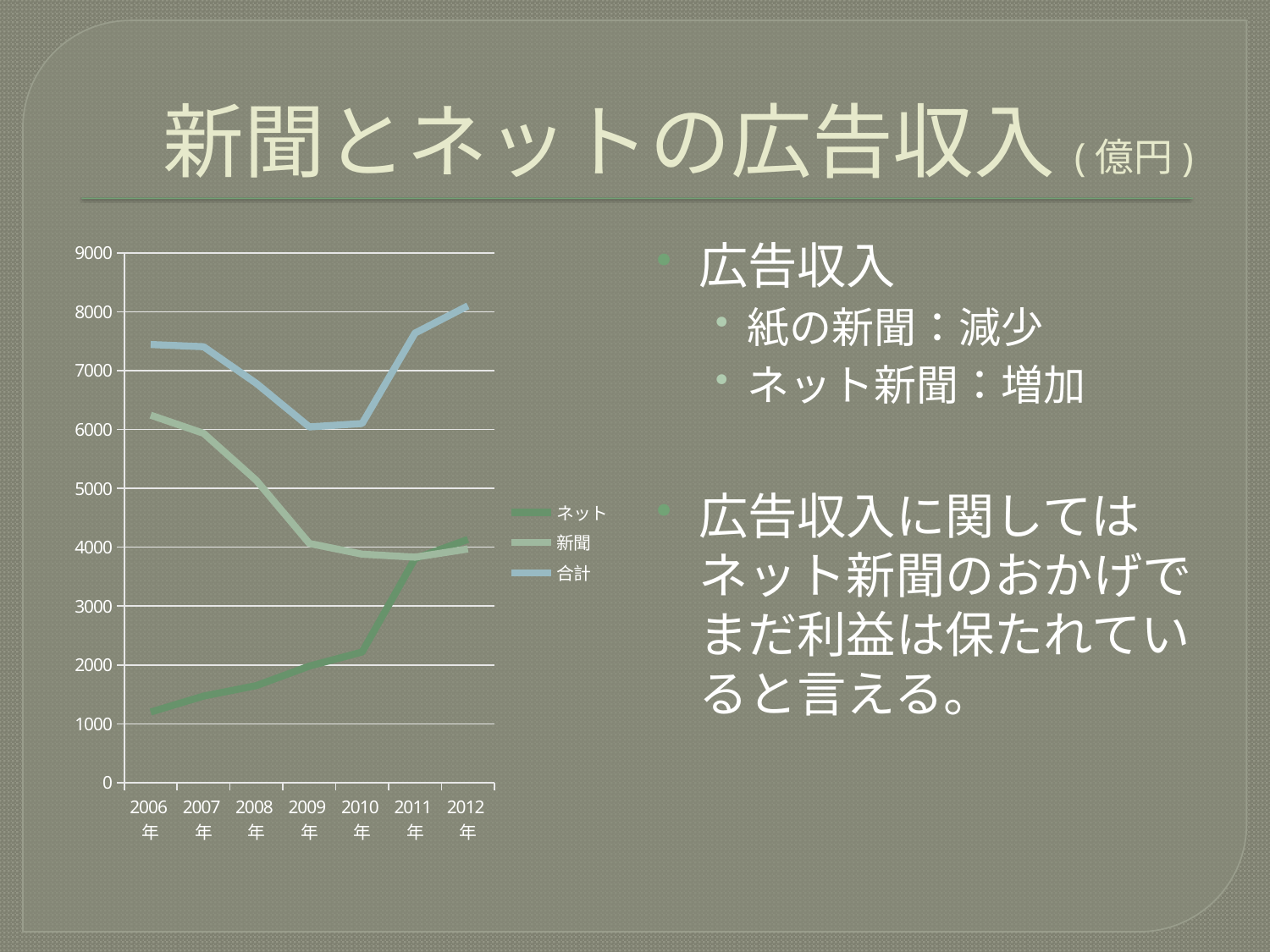
What kind of chart is shown on the slide? line chart Is the value for ネット in 2006年 greater or less than 2000? less Is the value for 合計 in 2012年 greater or less than 7000? greater Does the ネット series rise or fall from 2006年 to 2012年? rise What are the three entries listed in the chart's legend? ネット, 新聞, 合計 Does the 新聞 series rise or fall from 2006年 to 2012年? fall Is the value for 新聞 in 2012年 greater or less than 5000? less In 2008年, which series has the larger value, 新聞 or ネット? 新聞 How many years are shown along the x axis of the chart? 7 In which year is the ネット series at its lowest? 2006年 How many series does the chart's legend list? 3 In which year is the 合計 series at its highest? 2012年